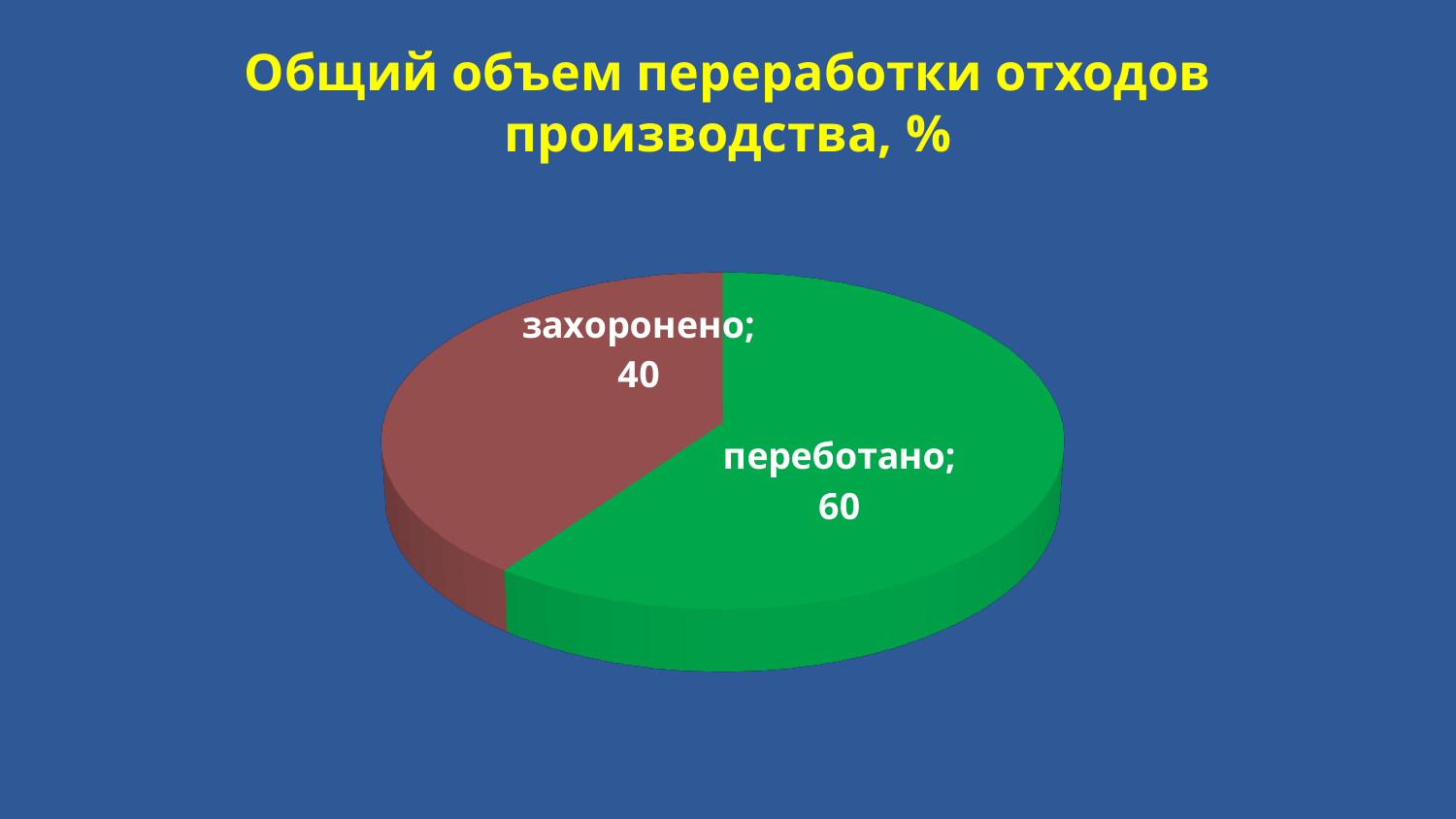
What share of the pie does захоронено represent? 40% Which category has the largest slice? переботано Which is larger, захоронено or переботано? переботано What colour is the slice for переботано? green Which category has the smallest slice? захоронено What kind of chart is shown on the slide? pie chart How many slices does the pie chart have? 2 What share of the pie does переботано represent? 60% What is the value for переботано? 60 What is the title of the chart? Общий объем переработки отходов производства, % What is the value for захоронено? 40 What is the difference between the values for переботано and захоронено? 20